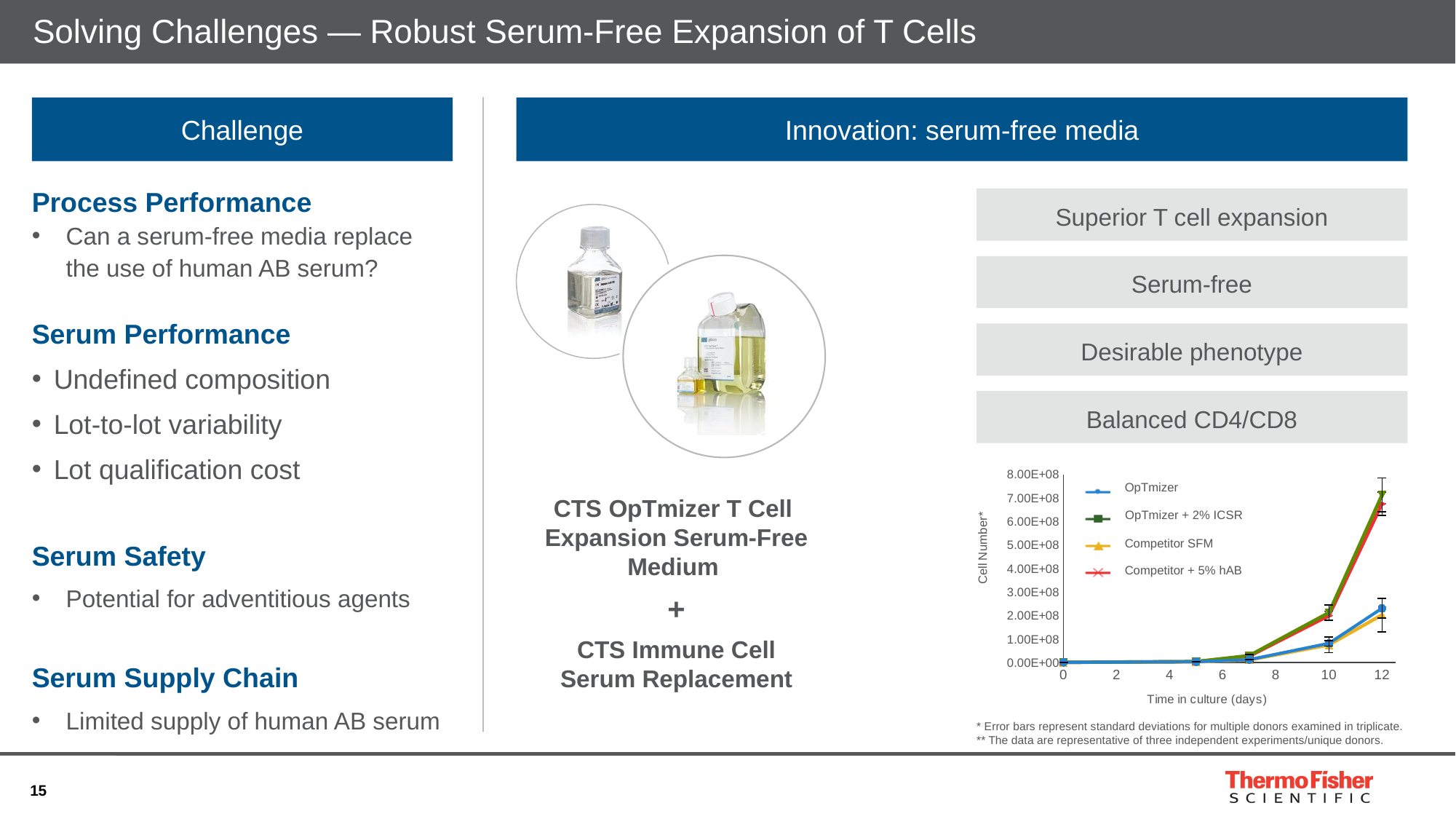
Is the value for OpTmizer at day 10 greater or less than 2.00E+08? less At day 12, which has the larger value: OpTmizer + 2% ICSR or OpTmizer? OpTmizer + 2% ICSR What kind of chart is shown on the slide? line chart Is the value for OpTmizer at day 12 greater or less than 3.00E+08? less Is the value for Competitor SFM at day 12 greater or less than 3.00E+08? less Do the cell numbers rise or fall as time in culture increases? rise What is the title of the y axis of the chart? Cell Number* What is the title of the x axis of the chart? Time in culture (days) At day 12, which has the larger value: Competitor + 5% hAB or Competitor SFM? Competitor + 5% hAB How many series does the chart legend list? 4